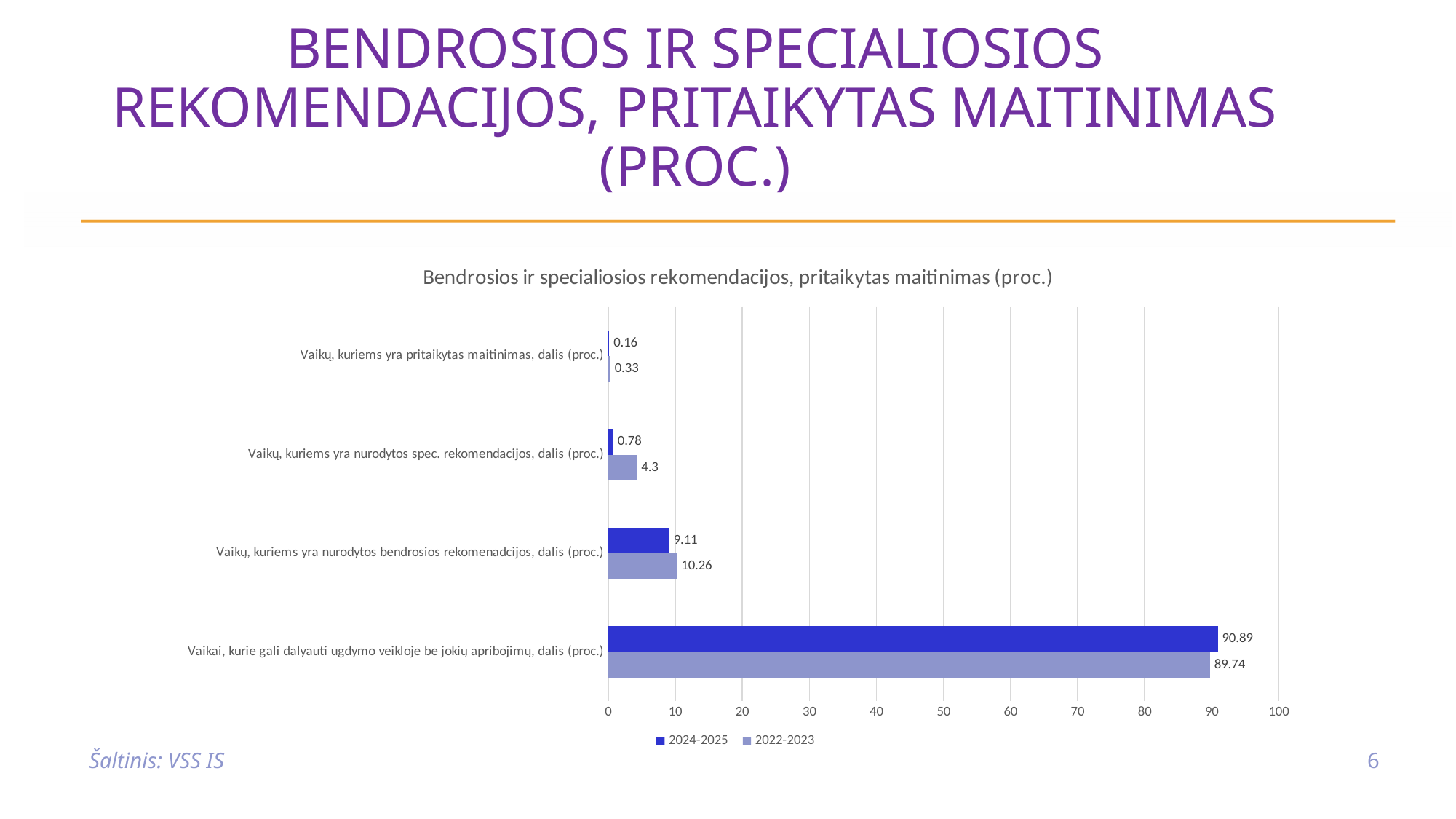
What is the difference between the 2024-2025 and 2022-2023 values for 'Vaikai, kurie gali dalyauti ugdymo veikloje be jokių apribojimų, dalis (proc.)'? 1.15 For 'Vaikų, kuriems yra nurodytos spec. rekomendacijos, dalis (proc.)', which series has the larger value, 2024-2025 or 2022-2023? 2022-2023 What is the 2022-2023 value for 'Vaikų, kuriems yra nurodytos bendrosios rekomenadcijos, dalis (proc.)'? 10.26 What is the title of the chart? Bendrosios ir specialiosios rekomendacijos, pritaikytas maitinimas (proc.) Which category has the lowest 2022-2023 value? Vaikų, kuriems yra pritaikytas maitinimas, dalis (proc.) What is the 2022-2023 value for 'Vaikų, kuriems yra nurodytos spec. rekomendacijos, dalis (proc.)'? 4.3 How many categories are shown on the chart? 4 How many series does the legend list? 2 What is the 2024-2025 value for 'Vaikai, kurie gali dalyauti ugdymo veikloje be jokių apribojimų, dalis (proc.)'? 90.89 What type of chart is shown on the slide? Bar chart What is the 2024-2025 value for 'Vaikų, kuriems yra pritaikytas maitinimas, dalis (proc.)'? 0.16 Which category has the highest 2024-2025 value? Vaikai, kurie gali dalyauti ugdymo veikloje be jokių apribojimų, dalis (proc.)